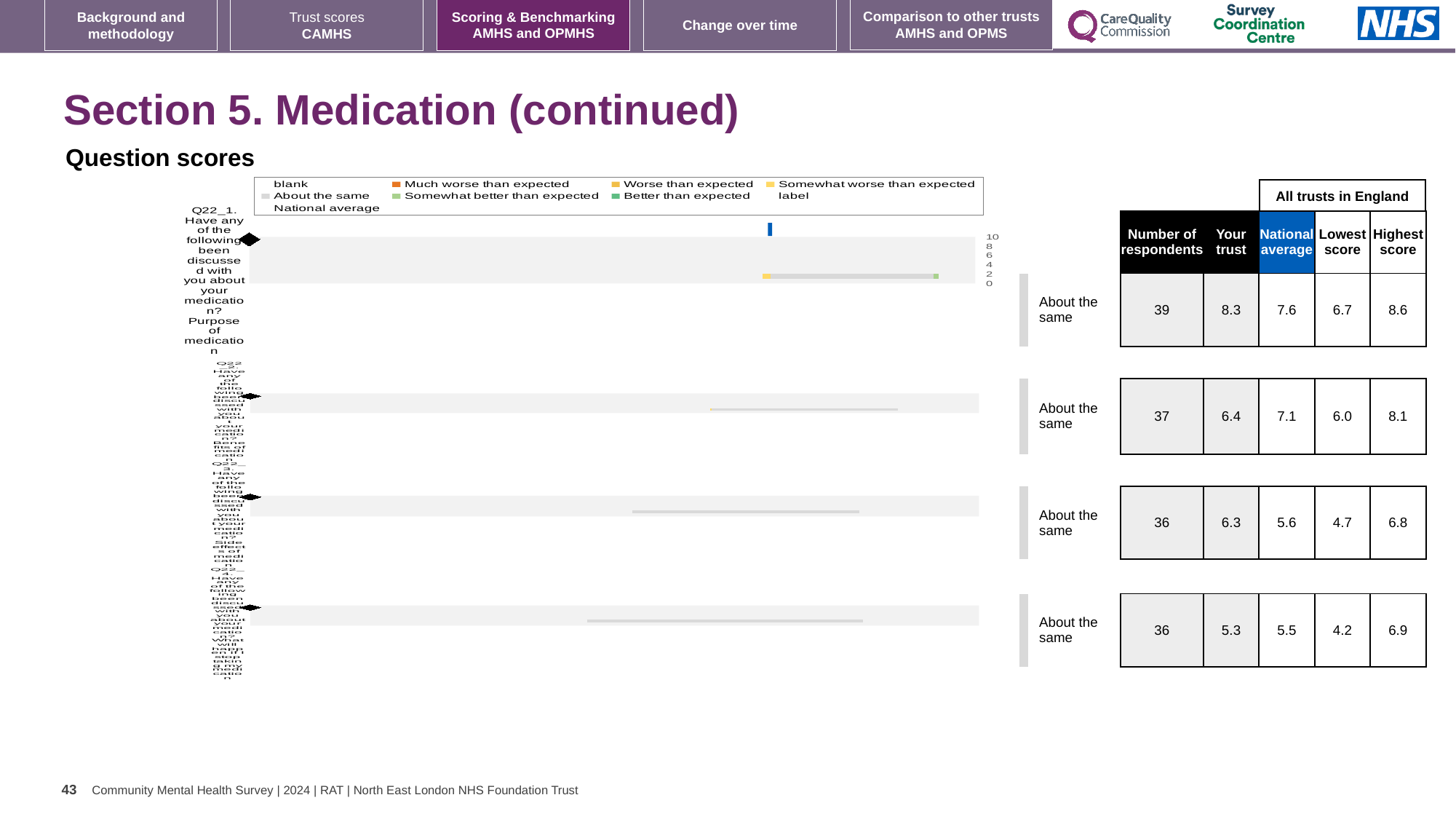
How many question charts are shown under 'Question scores' on this slide? 4 What kind of chart is used for the question scores on this slide? bar chart What benchmark category is shown beside the first question chart (Q22_1, Purpose of medication)? About the same What is the highest value shown on the axis of the first question chart (Q22_1)? 10 How many of the four question charts are labelled 'About the same'? 4 In the chart legend, what colour represents 'Much worse than expected'? orange